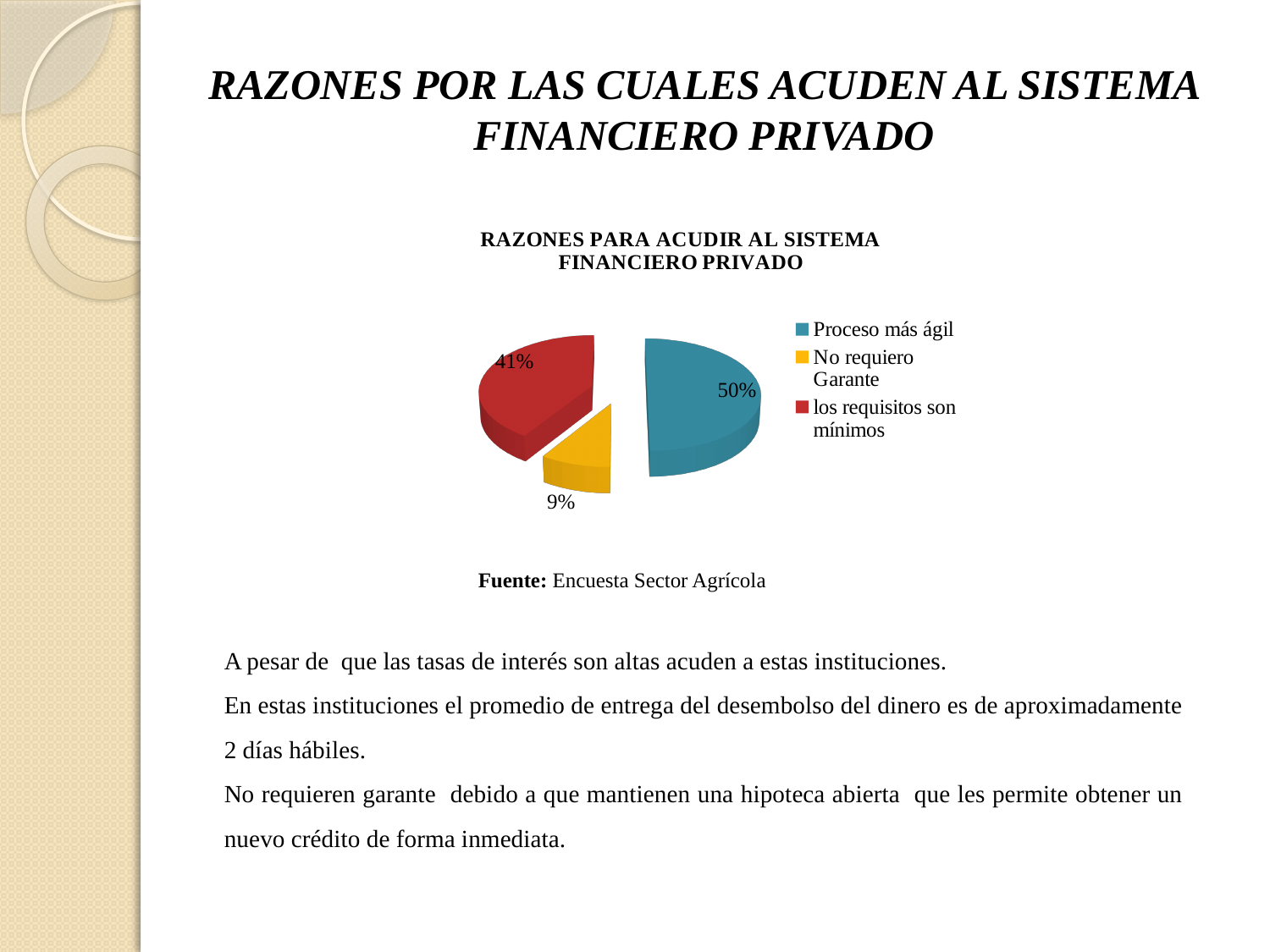
What colour is the slice for 'No requiero Garante'? Yellow How many slices does the pie chart have? 3 What kind of chart is shown on the slide? Pie chart Which category has the smallest share of the pie? No requiero Garante What is the title of the chart? RAZONES PARA ACUDIR AL SISTEMA FINANCIERO PRIVADO What percentage of the pie corresponds to 'los requisitos son mínimos'? 41% What is the difference in percentage points between 'Proceso más ágil' and 'los requisitos son mínimos'? 9 Which category has the largest share of the pie? Proceso más ágil Which is larger, the share for 'los requisitos son mínimos' or the share for 'No requiero Garante'? los requisitos son mínimos What percentage of the pie corresponds to 'No requiero Garante'? 9% How many entries does the legend list? 3 What percentage of the pie corresponds to 'Proceso más ágil'? 50%